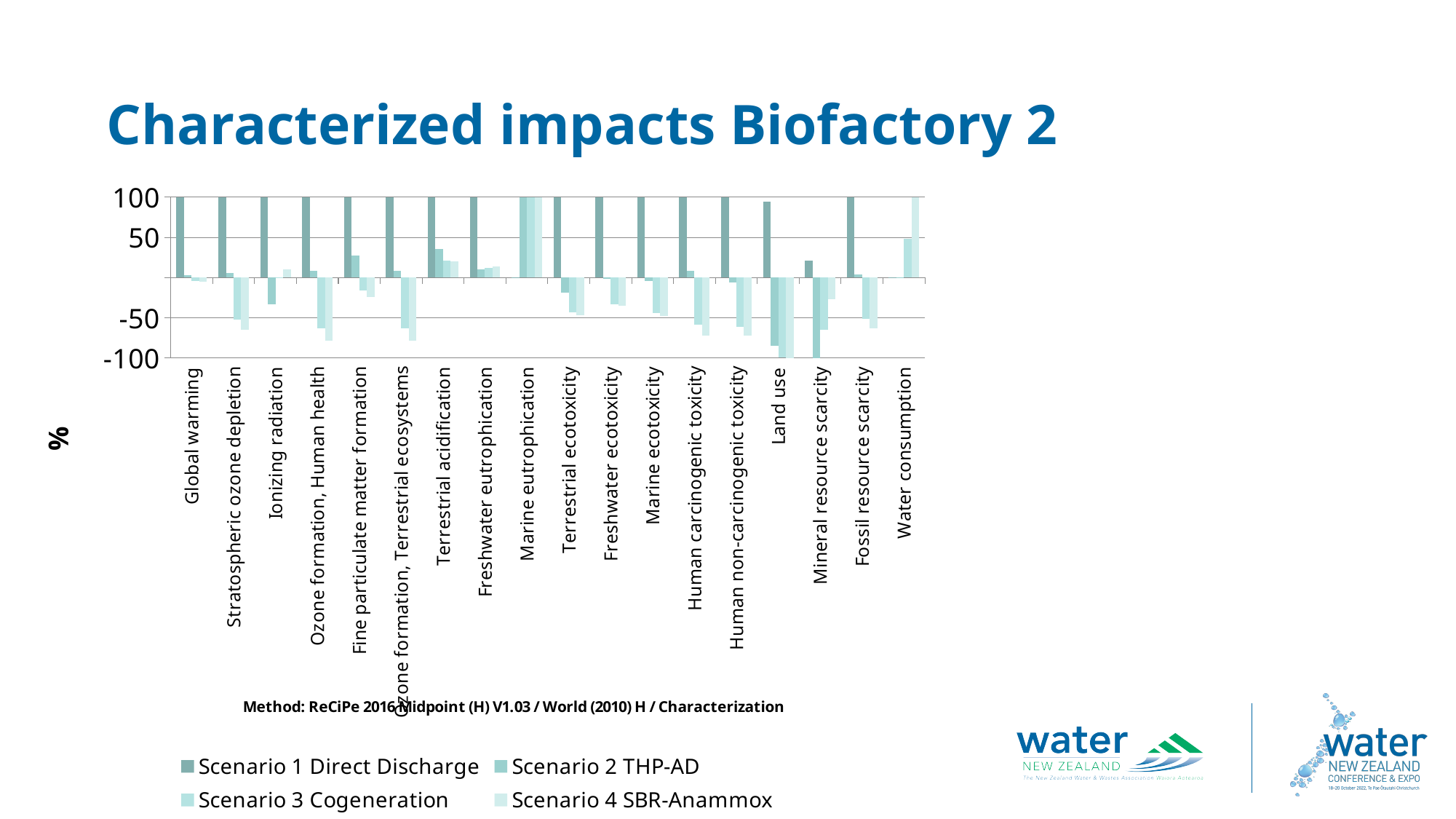
Which scenario has the highest value for Global warming? Scenario 1 Direct Discharge Is the Scenario 4 SBR-Anammox value for Water consumption greater or less than 50? greater How many series does the chart legend list? 4 For Scenario 1 Direct Discharge, which is larger: the value for Land use or the value for Mineral resource scarcity? Land use What kind of chart is shown on the slide? bar chart How many impact categories are shown on the x axis of the chart? 18 Is the Scenario 1 Direct Discharge value for Mineral resource scarcity greater or less than 50? less Is the Scenario 3 Cogeneration value for Land use greater or less than -50? less What label is shown on the vertical axis of the chart? % What is the title of the chart on the slide? Characterized impacts Biofactory 2